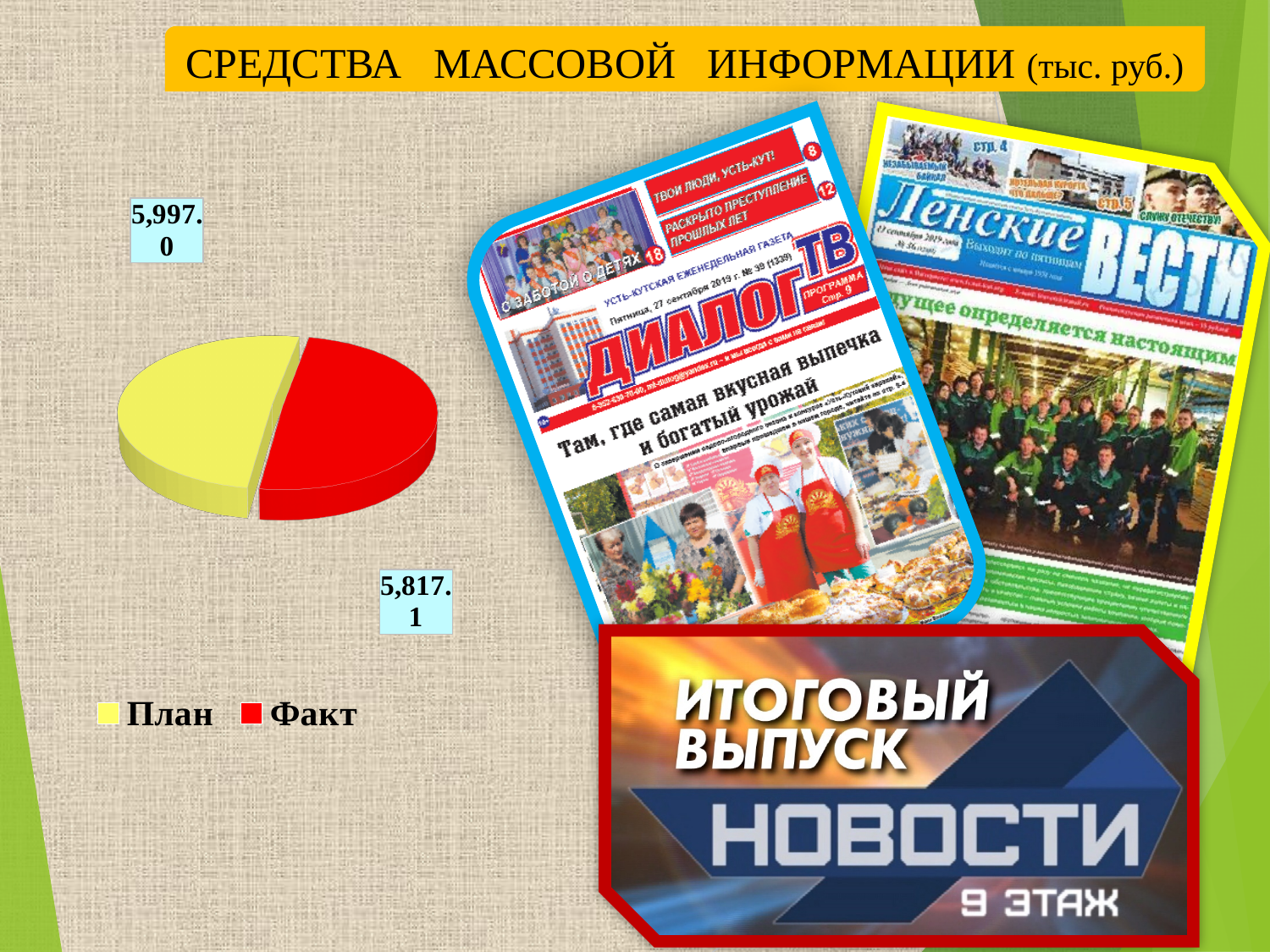
What is the total of the two values shown in the pie chart? 11,814.1 What type of chart is shown on the slide? pie chart Which colour represents Факт in the pie chart? red Which category has the larger value in the pie chart, План or Факт? План What is the value for План (Plan) in the pie chart? 5,997.0 How many entries does the chart legend list? 2 Is the value for Факт larger or smaller than the value for План? smaller What is the value for Факт (Fact) in the pie chart? 5,817.1 What unit is given in the slide title for the chart values? тыс. руб. Which category has the smaller value in the pie chart? Факт What is the difference between the План value and the Факт value? 179.9 How many slices does the pie chart have? 2